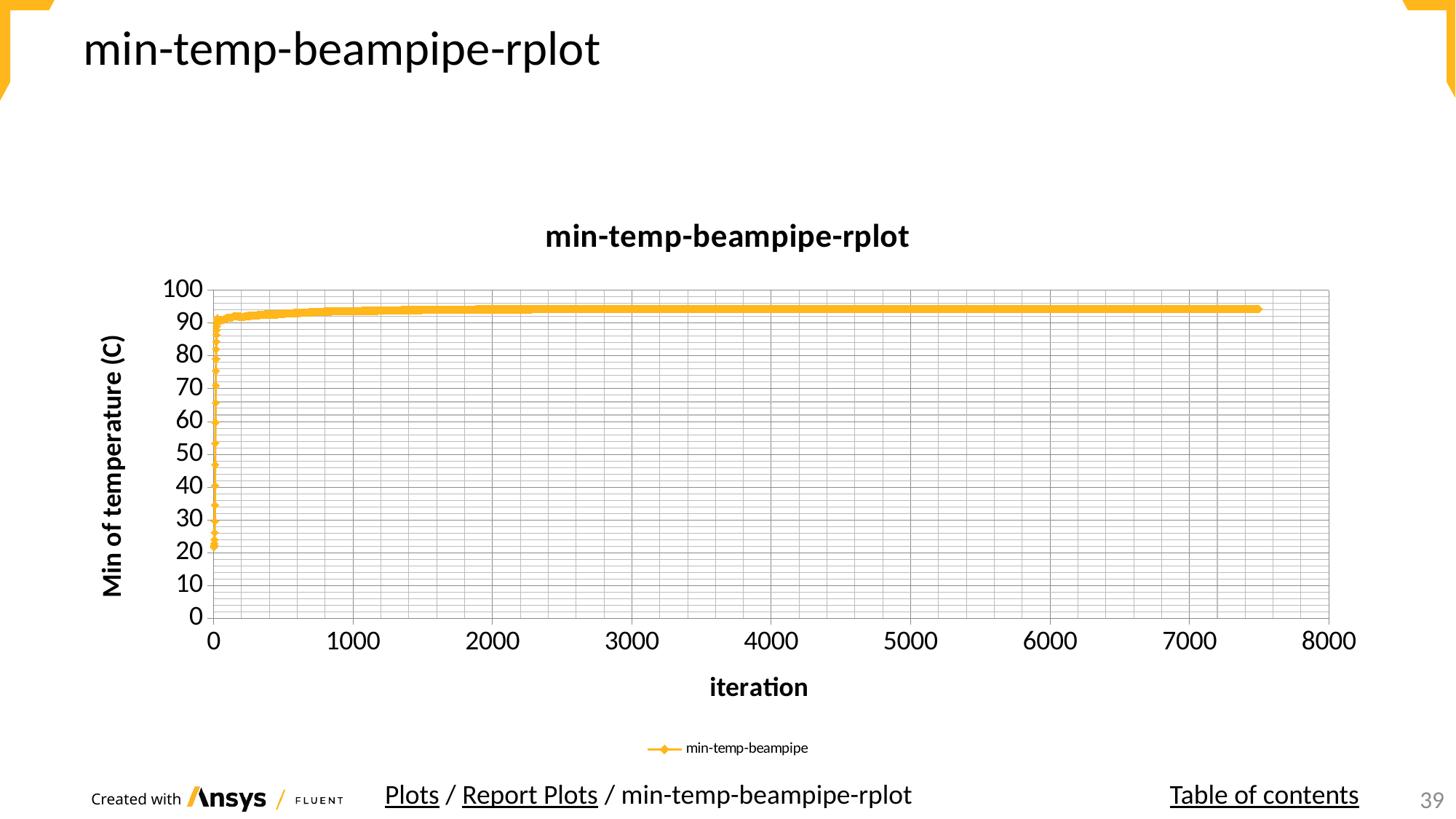
Do the values of min-temp-beampipe rise or fall as the iteration increases? rise Is the value of min-temp-beampipe at iteration 2000 greater or less than 100? less Which is larger: the value of min-temp-beampipe at iteration 0 or at iteration 5000? iteration 5000 What is the label of the y axis? Min of temperature (C) How many series does the legend list? 1 Is the value of min-temp-beampipe at iteration 4000 greater or less than 90? greater What is the name of the series shown in the legend? min-temp-beampipe Is the value of min-temp-beampipe at iteration 7000 greater or less than 50? greater What kind of chart is shown on the slide? line chart